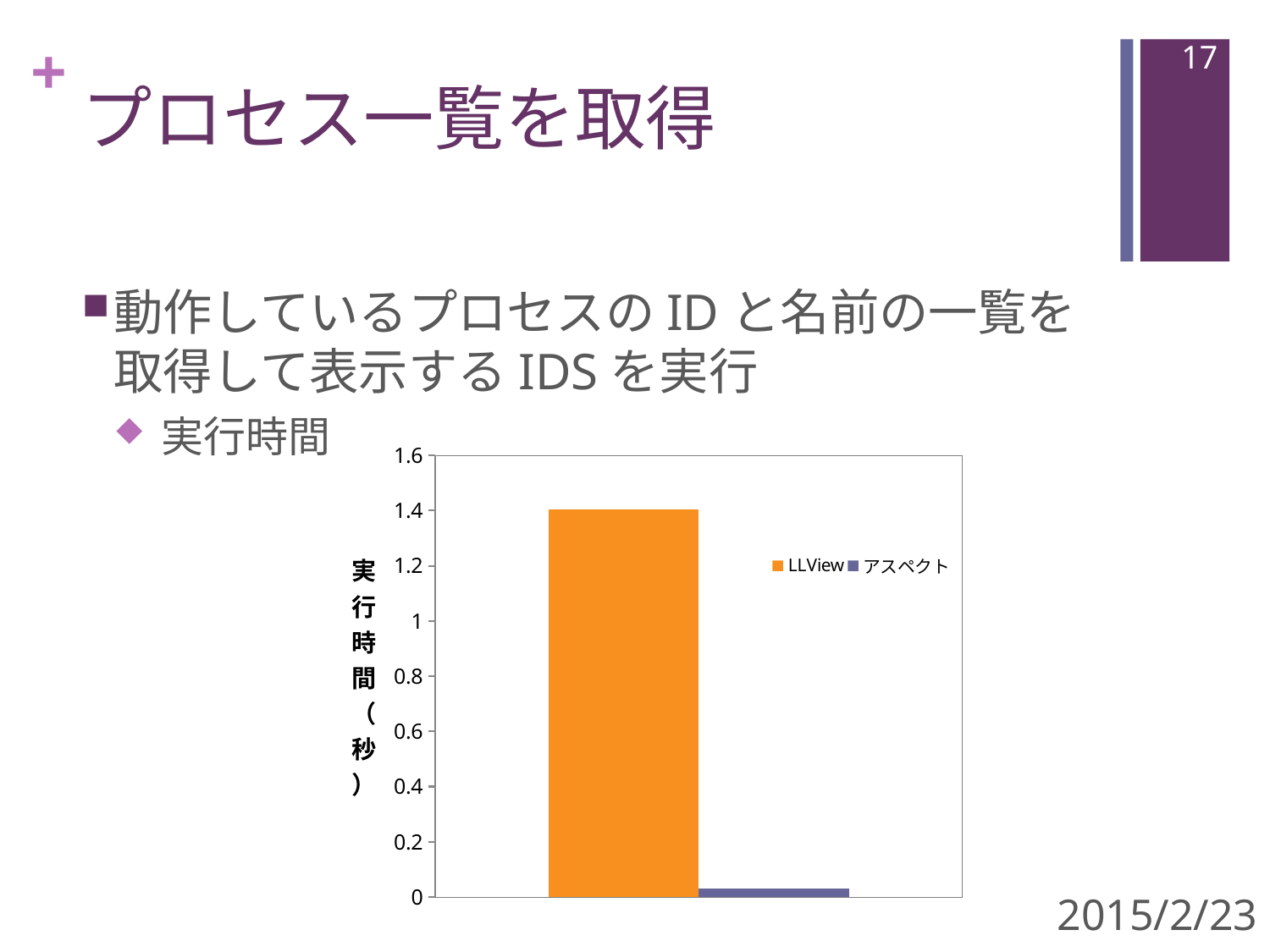
Is the value for アスペクト greater or less than 0.2? less What kind of chart is shown on the slide? bar chart Is the value for LLView greater or less than 1? greater How many series does the chart legend list? 2 Which series has the higher execution time, LLView or アスペクト? LLView What is the maximum value shown on the vertical axis of the chart? 1.6 Which colour represents the LLView series in the chart? orange Which series has the highest execution time in the chart? LLView Which series has the lowest execution time in the chart? アスペクト What is the label of the vertical axis of the chart? 実行時間(秒)